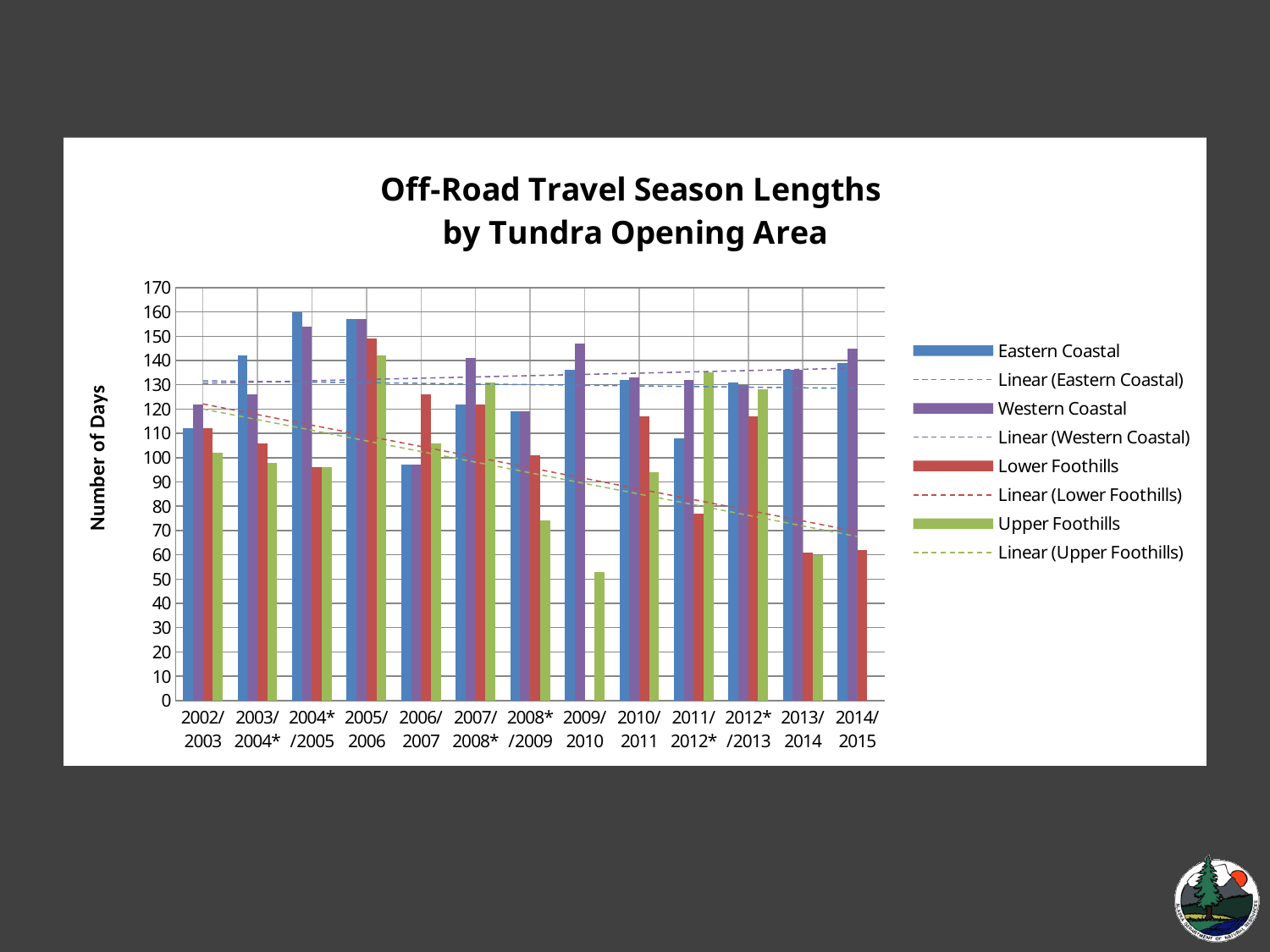
Is the Lower Foothills value for 2013/2014 greater or less than 70? less In 2006/2007, which is larger: the Lower Foothills value or the Eastern Coastal value? Lower Foothills How many entries does the legend list? 8 How many seasons are shown along the x axis? 13 Is the Eastern Coastal value for 2004*/2005 greater or less than 150? greater Is the Upper Foothills value for 2009/2010 greater or less than 60? less In which season is the Lower Foothills value highest? 2005/2006 What is the label on the vertical axis? Number of Days What kind of chart is shown on the slide? bar chart Does the Linear (Lower Foothills) trendline rise or fall from left to right? fall